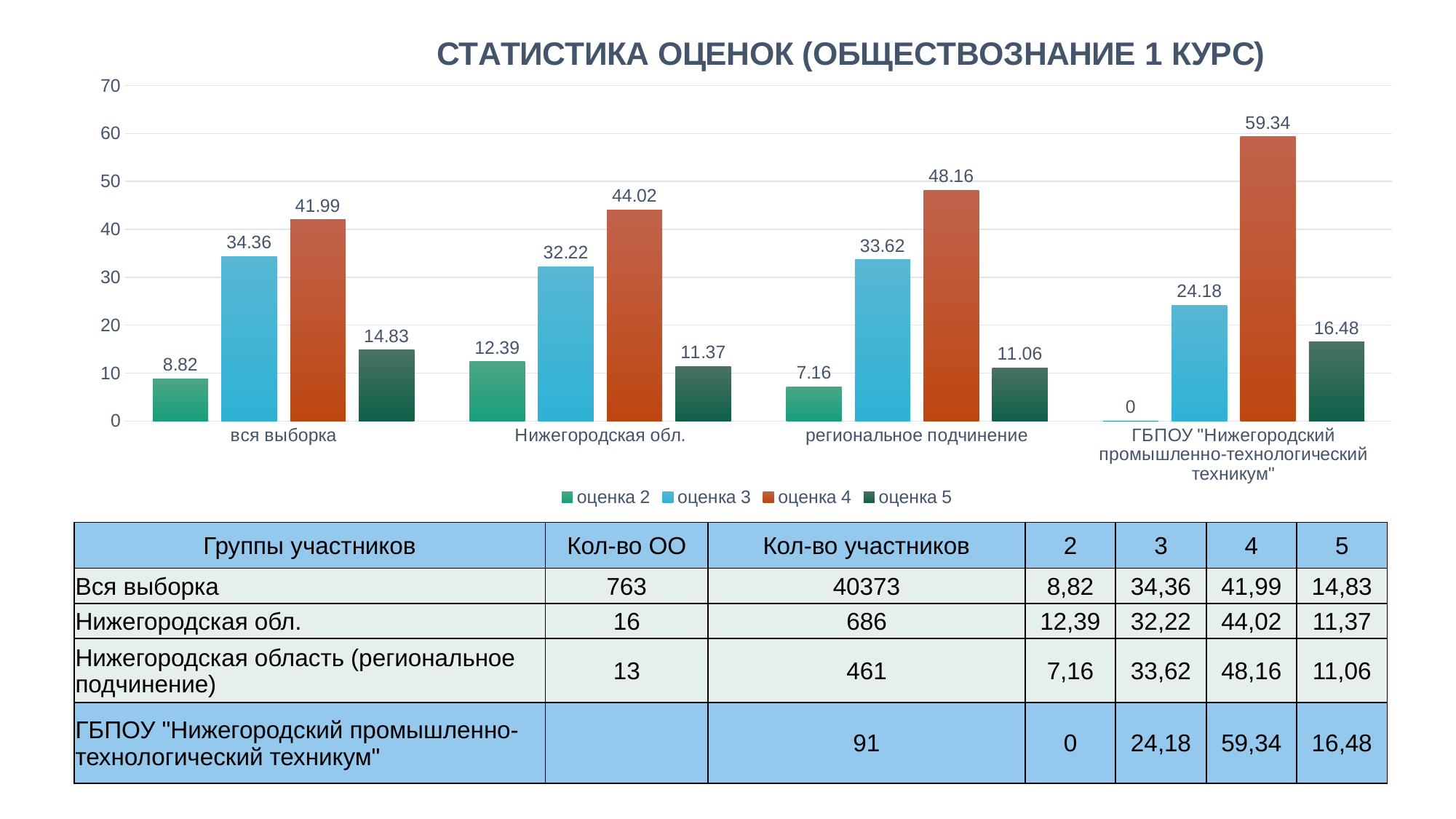
What kind of chart is shown on the slide? bar chart Which category has the lowest value for оценка 3? ГБПОУ "Нижегородский промышленно-технологический техникум" What is the value of оценка 3 for Нижегородская обл.? 32.22 Which is larger for вся выборка: оценка 2 or оценка 5? оценка 5 Does the value of оценка 4 rise or fall from left to right across the categories? rise What is the value of оценка 4 for вся выборка? 41.99 What is the value of оценка 5 for региональное подчинение? 11.06 What is the value of оценка 2 for ГБПОУ "Нижегородский промышленно-технологический техникум"? 0 Which category has the highest value for оценка 4? ГБПОУ "Нижегородский промышленно-технологический техникум" What is the difference between оценка 4 and оценка 3 for региональное подчинение? 14.54 How many series does the legend list? 4 How many categories are shown on the x axis? 4